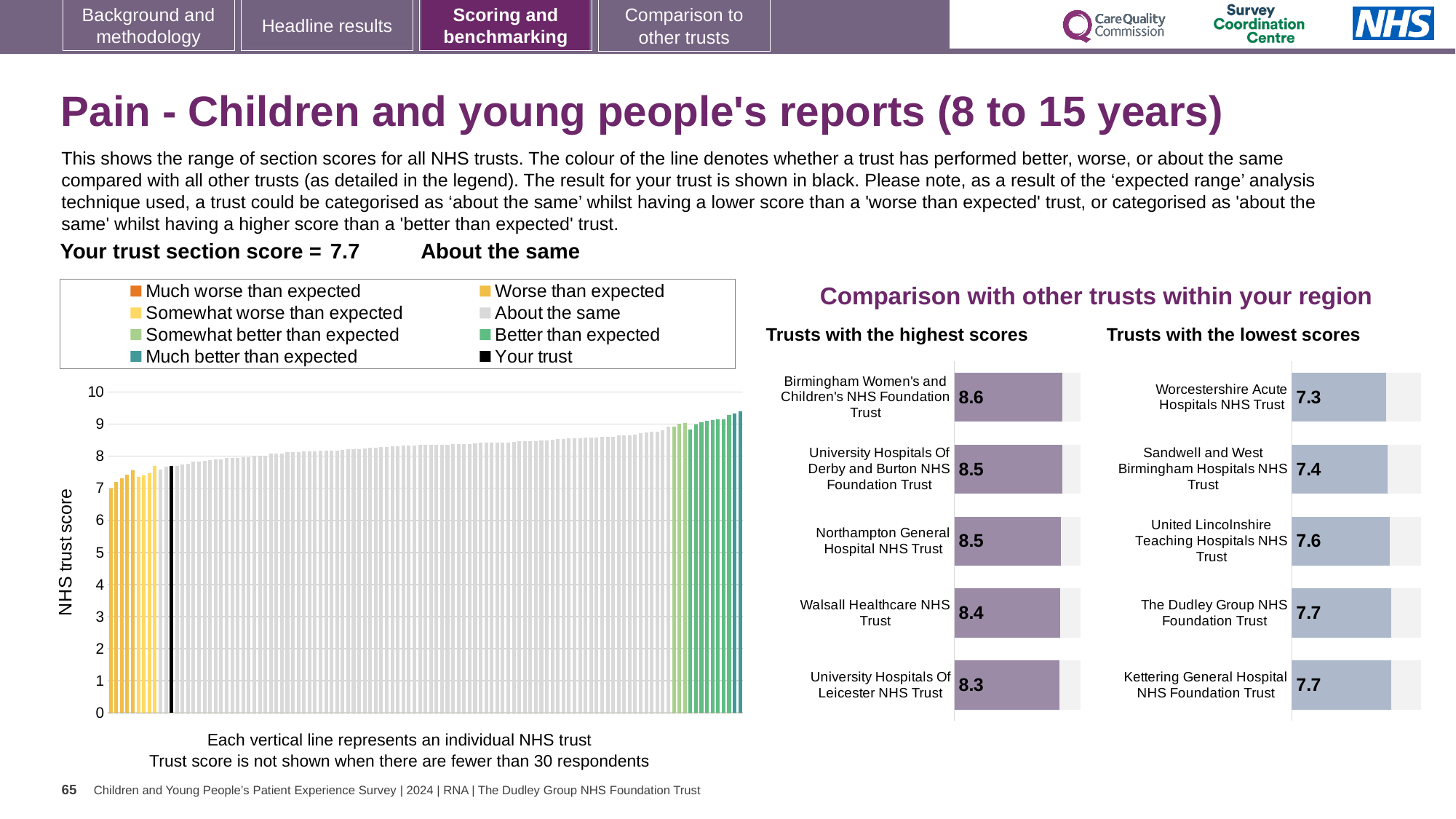
In the 'Trusts with the lowest scores' chart, which has the higher score: Sandwell and West Birmingham Hospitals NHS Trust or United Lincolnshire Teaching Hospitals NHS Trust? United Lincolnshire Teaching Hospitals NHS Trust In the 'Trusts with the lowest scores' chart, which trust has the lowest score? Worcestershire Acute Hospitals NHS Trust In the 'Trusts with the lowest scores' chart, what is the score for Worcestershire Acute Hospitals NHS Trust? 7.3 In the 'Trusts with the highest scores' chart, which trust has the highest score? Birmingham Women's and Children's NHS Foundation Trust In the 'Trusts with the highest scores' chart, what is the score for Birmingham Women's and Children's NHS Foundation Trust? 8.6 In the 'Trusts with the highest scores' chart, what is the score for Walsall Healthcare NHS Trust? 8.4 In the NHS trust score chart, is the value for the black 'Your trust' bar greater or less than 8? less In the 'Trusts with the lowest scores' chart, what is the difference between the scores of The Dudley Group NHS Foundation Trust and Worcestershire Acute Hospitals NHS Trust? 0.4 How many entries does the legend of the NHS trust score chart list? 8 How many trusts are shown in the 'Trusts with the lowest scores' chart? 5 In the 'Trusts with the highest scores' chart, what is the difference between the scores of Birmingham Women's and Children's NHS Foundation Trust and University Hospitals Of Leicester NHS Trust? 0.3 In the NHS trust score chart, do the bar values rise or fall from left to right? rise